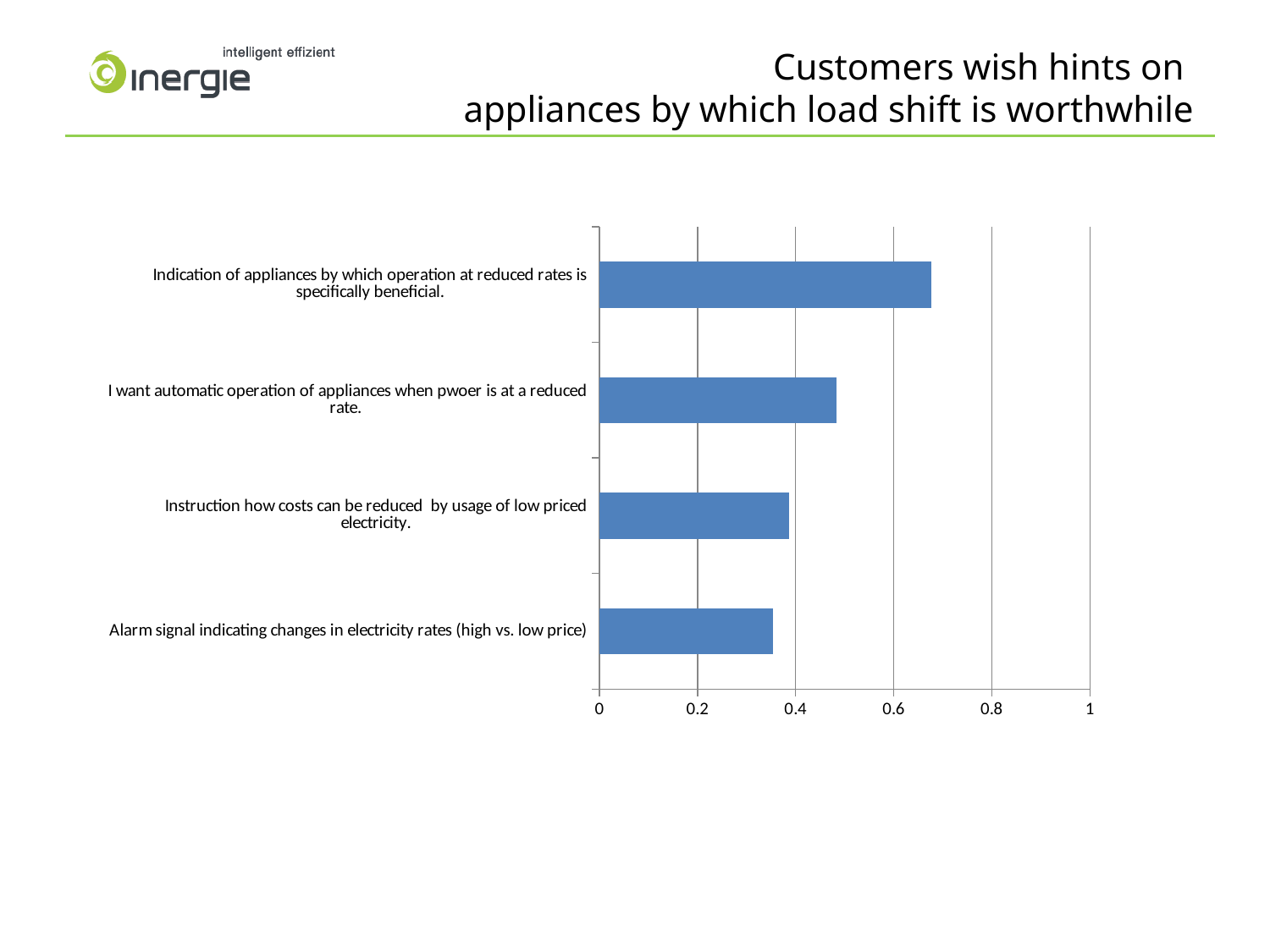
Which has the larger value: "Indication of appliances by which operation at reduced rates is specifically beneficial." or "Alarm signal indicating changes in electricity rates (high vs. low price)"? Indication of appliances by which operation at reduced rates is specifically beneficial. What is the maximum value shown on the horizontal axis of the chart? 1 What kind of chart is shown on the slide? bar chart How many categories are plotted in the chart? 4 Which category has the highest value in the chart? Indication of appliances by which operation at reduced rates is specifically beneficial. Is the value for "Alarm signal indicating changes in electricity rates (high vs. low price)" greater or less than 0.4? less Is the value for "Instruction how costs can be reduced by usage of low priced electricity." greater or less than 0.2? greater Which has the larger value: "I want automatic operation of appliances when pwoer is at a reduced rate." or "Instruction how costs can be reduced by usage of low priced electricity."? I want automatic operation of appliances when pwoer is at a reduced rate. What is the title of the slide containing the chart? Customers wish hints on appliances by which load shift is worthwhile Is the value for "I want automatic operation of appliances when pwoer is at a reduced rate." greater or less than 0.4? greater